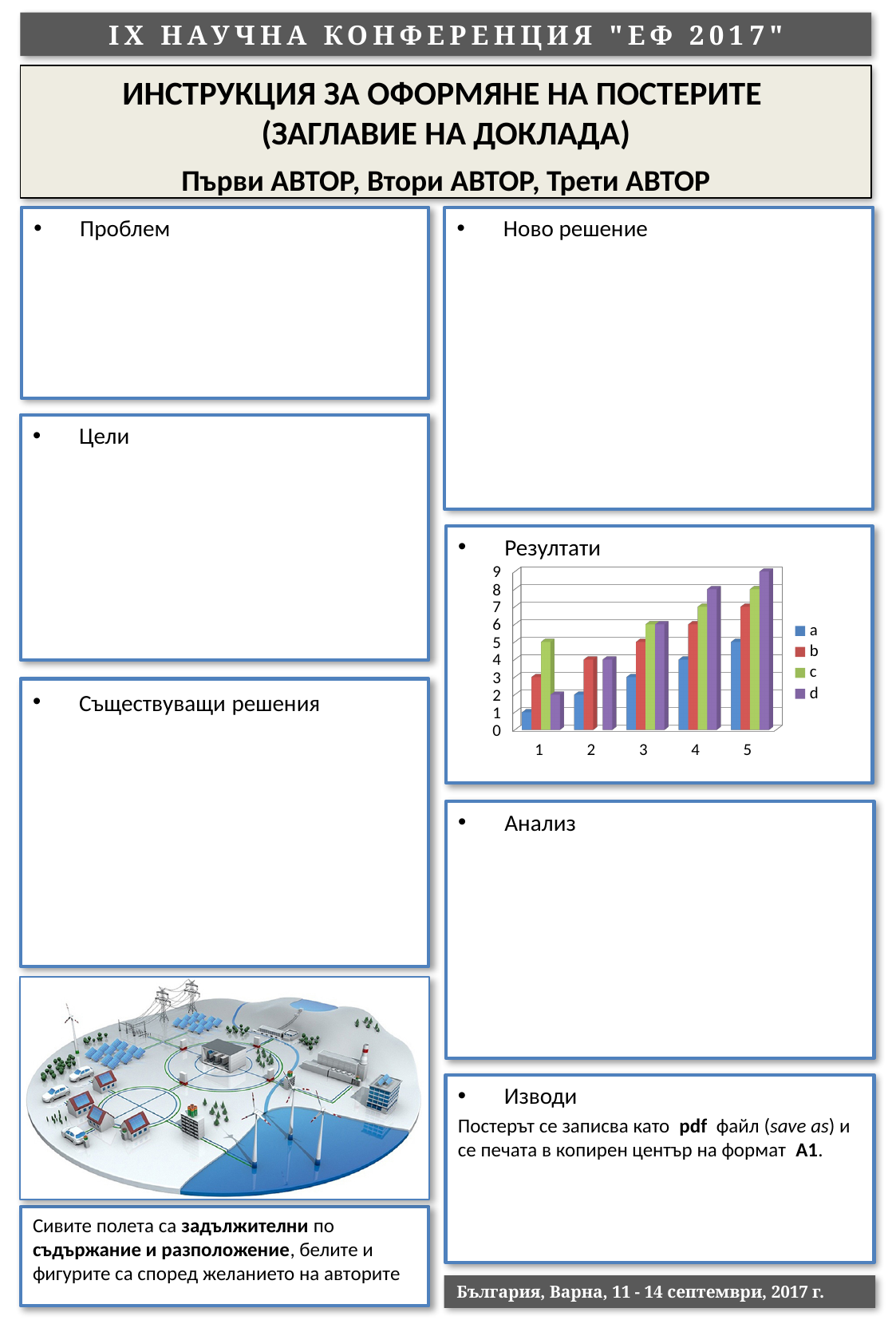
In the "Резултати" chart, is the value of series d at category 5 greater or less than 7? greater In the "Резултати" chart, do the values of series a rise or fall from category 1 to category 5? rise What kind of chart is shown in the "Резултати" box? bar chart In the "Резултати" chart, which is larger at category 5: series a or series d? d In the "Резултати" chart, is the value of series a at category 1 greater or less than 2? less In the "Резултати" chart, do the values of series d rise or fall from category 1 to category 5? rise In the "Резултати" chart, is the value of series c at category 1 greater or less than 4? greater What are the legend entries of the "Резултати" chart? a, b, c, d In the "Резултати" chart, which series has the lowest value at category 1? a How many categories are shown on the x axis of the "Резултати" chart? 5 In the "Резултати" chart, which series has the highest value at category 5? d How many series does the legend of the "Резултати" chart list? 4